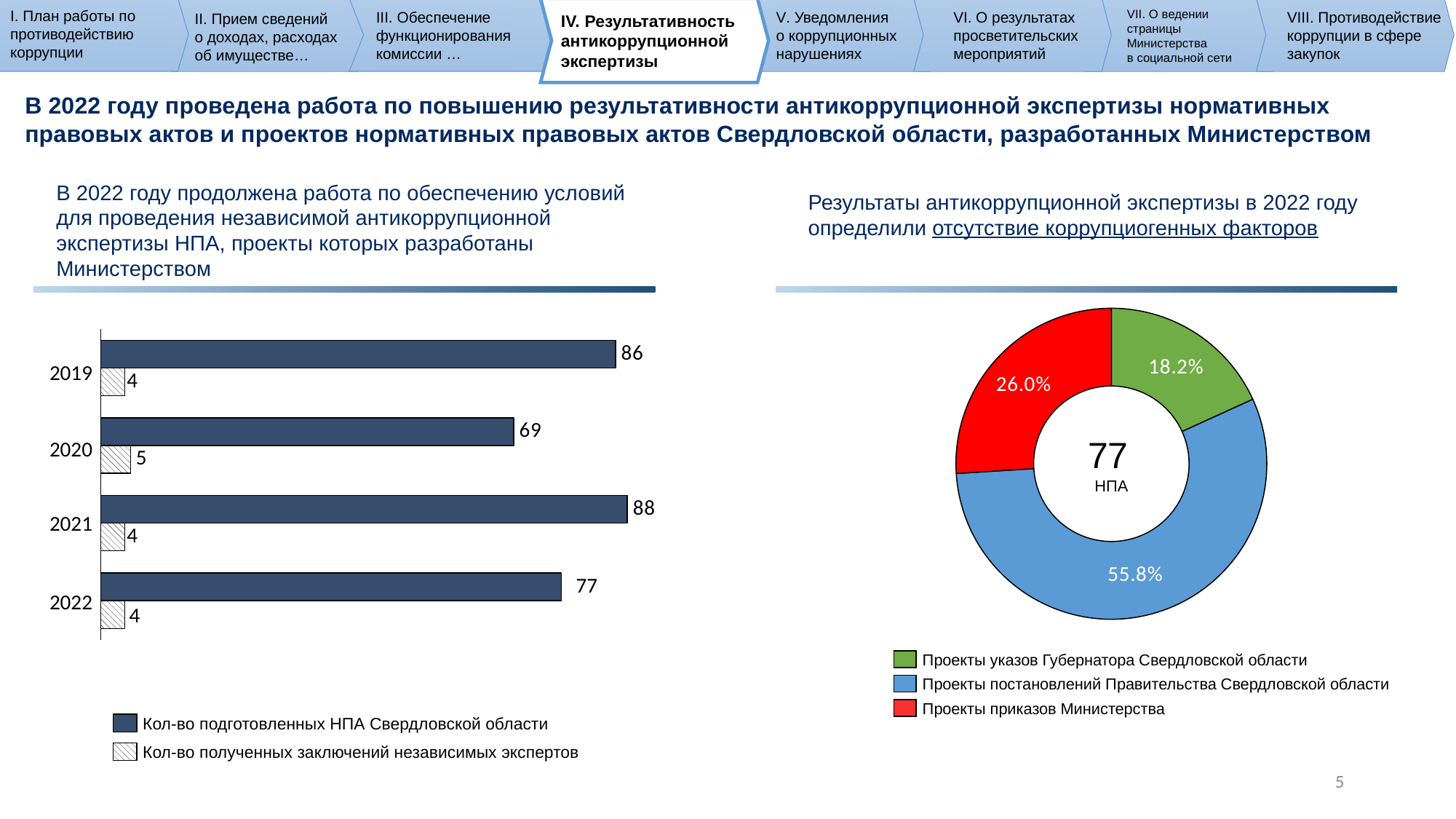
In the bar chart on the left, what is the value of 'Кол-во подготовленных НПА Свердловской области' for 2021? 88 In the bar chart on the left, which year has the highest value for 'Кол-во подготовленных НПА Свердловской области'? 2021 How many series does the legend of the bar chart on the left list? 2 What number is shown in the centre of the doughnut chart on the right? 77 НПА In the bar chart on the left, what is the difference between the 'Кол-во подготовленных НПА Свердловской области' values for 2019 and 2022? 9 In the doughnut chart on the right, what share is 'Проекты постановлений Правительства Свердловской области'? 55.8% How many years are shown in the bar chart on the left? 4 What kind of chart is shown on the left side of the slide? Bar chart In the bar chart on the left, what is the value of 'Кол-во полученных заключений независимых экспертов' for 2020? 5 In the bar chart on the left, which is larger: 'Кол-во подготовленных НПА Свердловской области' for 2020 or for 2022? 2022 In the bar chart on the left, which year has the lowest value for 'Кол-во подготовленных НПА Свердловской области'? 2020 In the doughnut chart on the right, which category has the smallest share? Проекты указов Губернатора Свердловской области